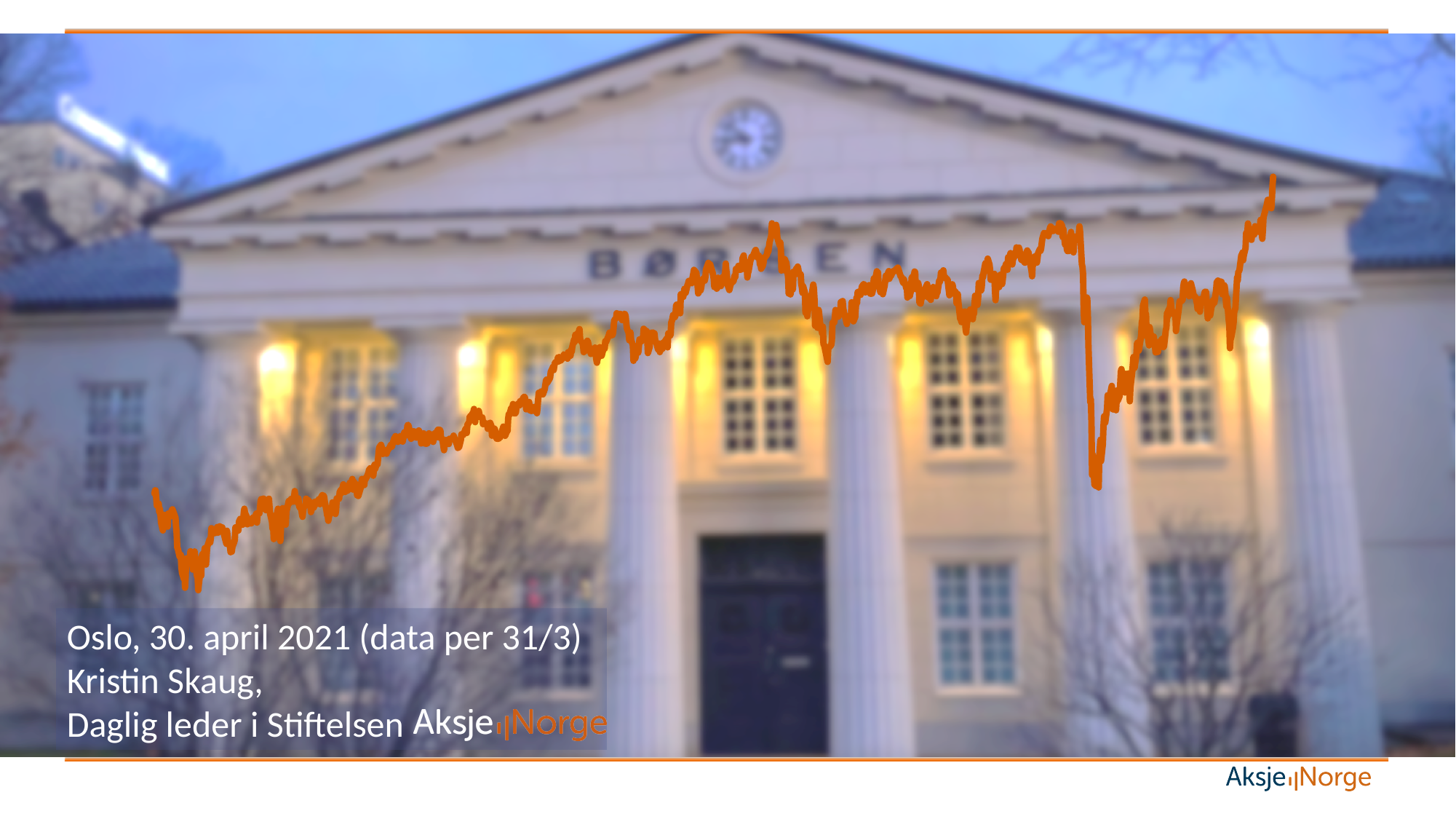
Does the chart show any axis labels or data values? no How many lines are plotted in the chart? 1 What colour is the line in the chart? orange Does the line in the chart generally rise or fall from left to right? rise What kind of chart is overlaid on the photo of the stock exchange building? line chart